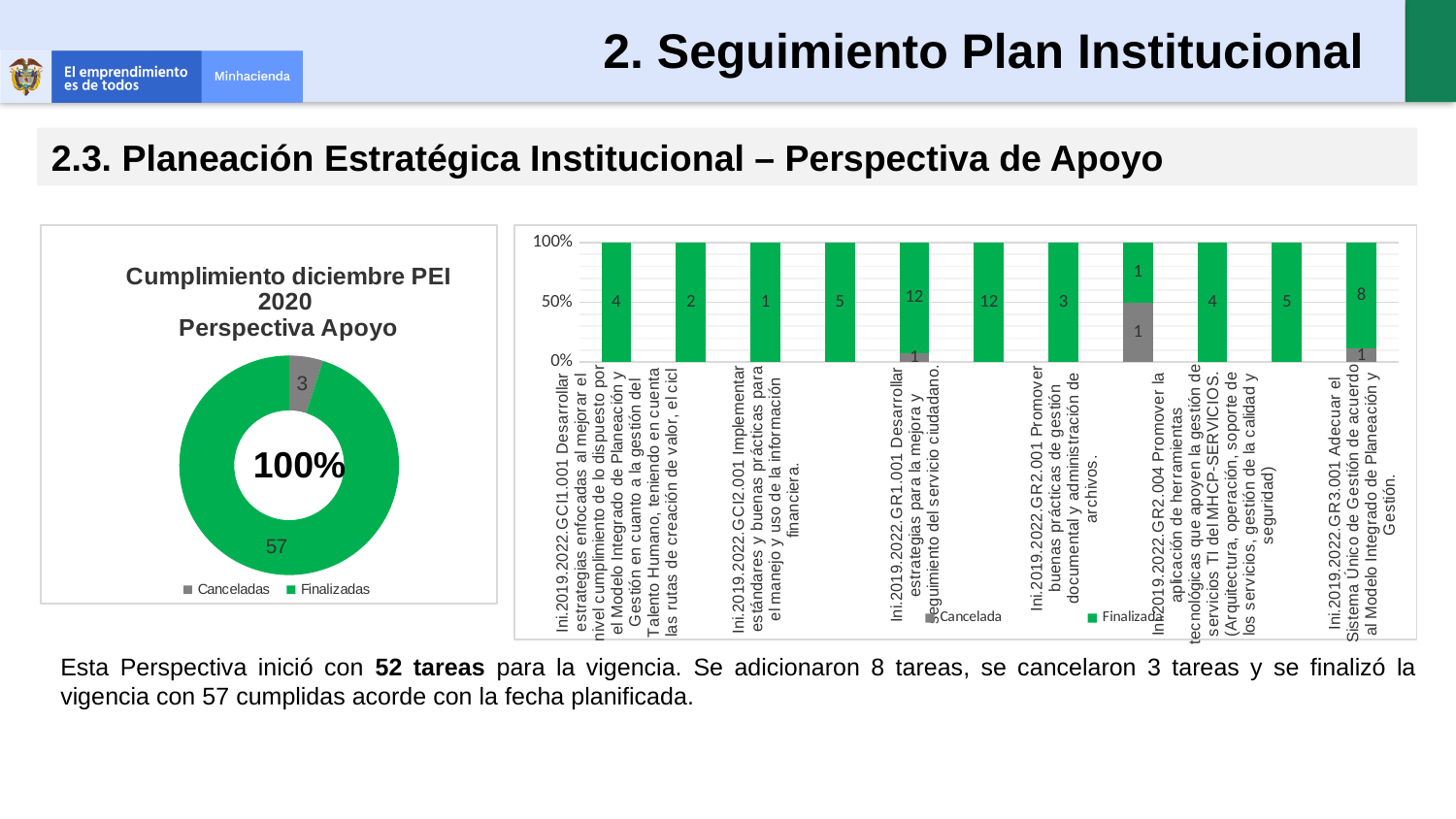
How many bars are plotted in the stacked bar chart on the right? 11 What percentage is shown in the centre of the donut chart on the left? 100% In the stacked bar chart on the right, what is the Finalizada value for Ini.2019.2022.GR1.001? 12 In the donut chart on the left, what is the difference between the Finalizadas and Canceladas values? 54 In the donut chart titled 'Cumplimiento diciembre PEI 2020 Perspectiva Apoyo', what is the value for Finalizadas? 57 In the stacked bar chart on the right, what is the Cancelada value for Ini.2019.2022.GR1.001? 1 What kind of chart is the chart on the right of the slide? Stacked bar chart In the stacked bar chart on the right, what is the total of the bar for Ini.2019.2022.GR3.001? 9 What kind of chart is the chart on the left of the slide? Donut (pie) chart How many series does the legend of the stacked bar chart on the right list? 2 In the donut chart titled 'Cumplimiento diciembre PEI 2020 Perspectiva Apoyo', what is the value for Canceladas? 3 In the donut chart on the left, which category is larger, Canceladas or Finalizadas? Finalizadas